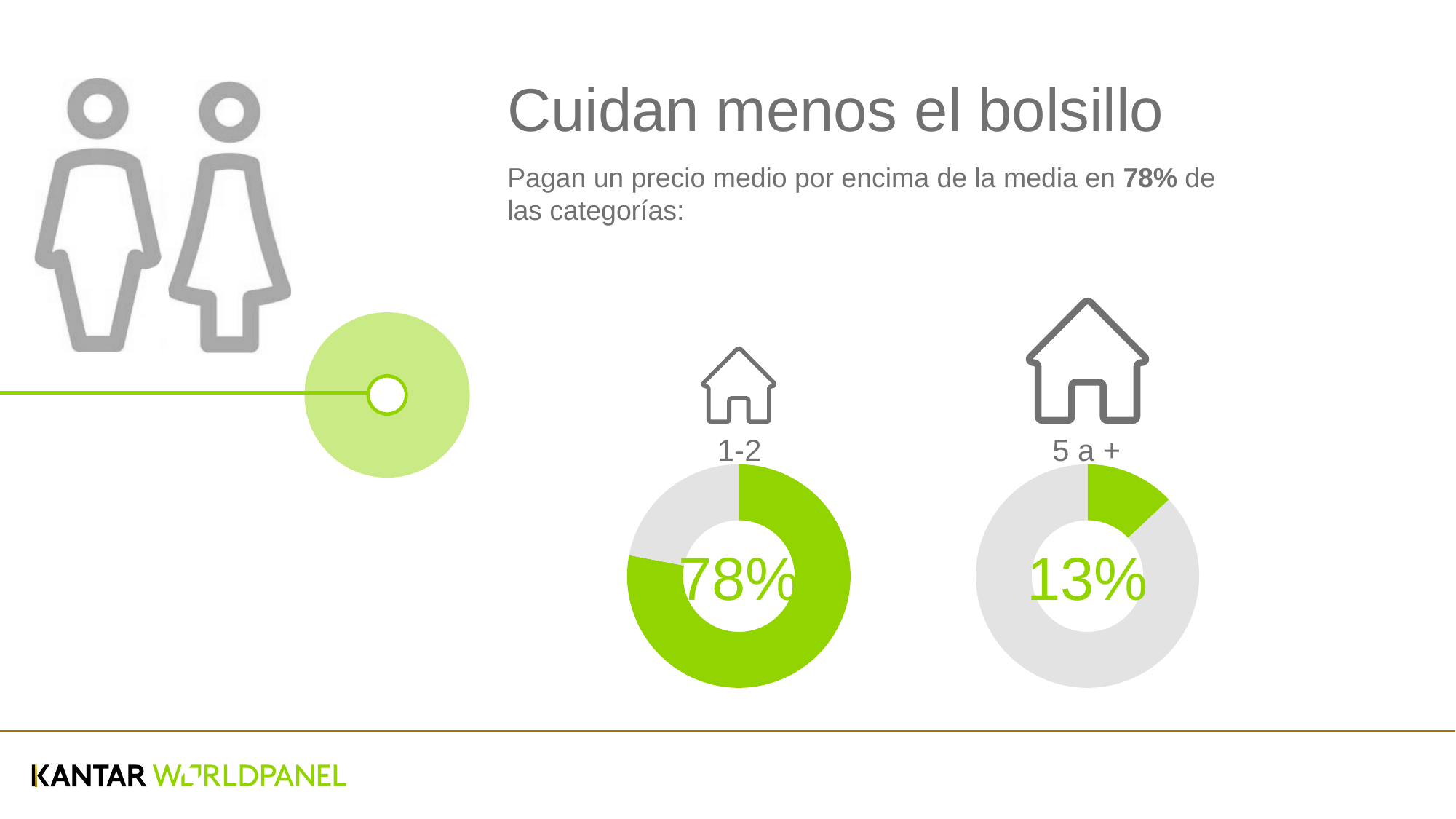
Which of the two donut charts shows the lower value, "1-2" or "5 a +"? 5 a + Is the value for "1-2" larger or smaller than the value for "5 a +"? larger How many donut charts are shown on the slide? 2 Which of the two donut charts shows the higher value, "1-2" or "5 a +"? 1-2 What value is shown in the centre of the donut chart labelled "5 a +"? 13% What is the title of the slide? Cuidan menos el bolsillo In the donut chart labelled "1-2", what share of the ring is filled in green? 78% What value is shown in the centre of the donut chart labelled "1-2"? 78% What kind of chart is used to show the 78% and 13% values? donut chart What is the difference between the value for "1-2" and the value for "5 a +"? 65% What is the label above the left donut chart? 1-2 In the donut chart labelled "5 a +", what share of the ring is filled in green? 13%